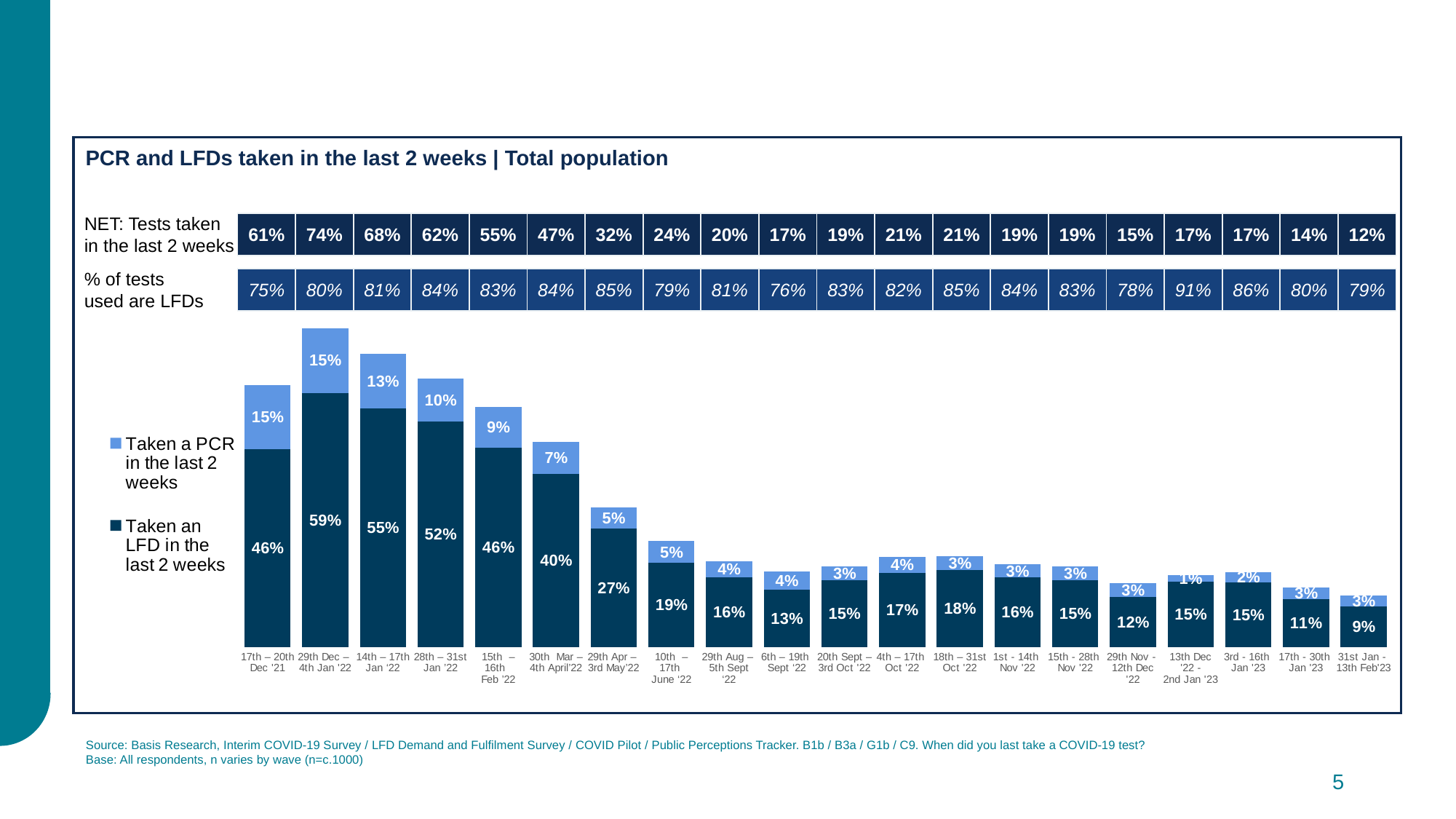
Which wave has the lowest percentage of people who had taken an LFD in the last 2 weeks? 31st Jan - 13th Feb '23 What is the NET percentage of tests taken in the last 2 weeks for the 10th – 17th June '22 wave? 24% What type of chart is shown on the slide? stacked bar chart Which is larger: the LFD percentage for 18th – 31st Oct '22 or for 29th Nov - 12th Dec '22? 18th – 31st Oct '22 Do the LFD percentages generally rise or fall from the 29th Dec – 4th Jan '22 wave to the 31st Jan - 13th Feb '23 wave? fall How many time periods (bars) are plotted on the chart? 20 What percentage had taken an LFD in the last 2 weeks in the 29th Dec – 4th Jan '22 wave? 59% What is the difference between the LFD percentage in the 14th – 17th Jan '22 wave and the 29th Apr – 3rd May '22 wave? 28% How many series does the legend list? 2 What is the total of the stacked bar for the 17th – 20th Dec '21 wave? 61% What percentage had taken a PCR in the last 2 weeks in the 30th Mar – 4th April '22 wave? 7% Which wave has the highest percentage of people who had taken an LFD in the last 2 weeks? 29th Dec – 4th Jan '22